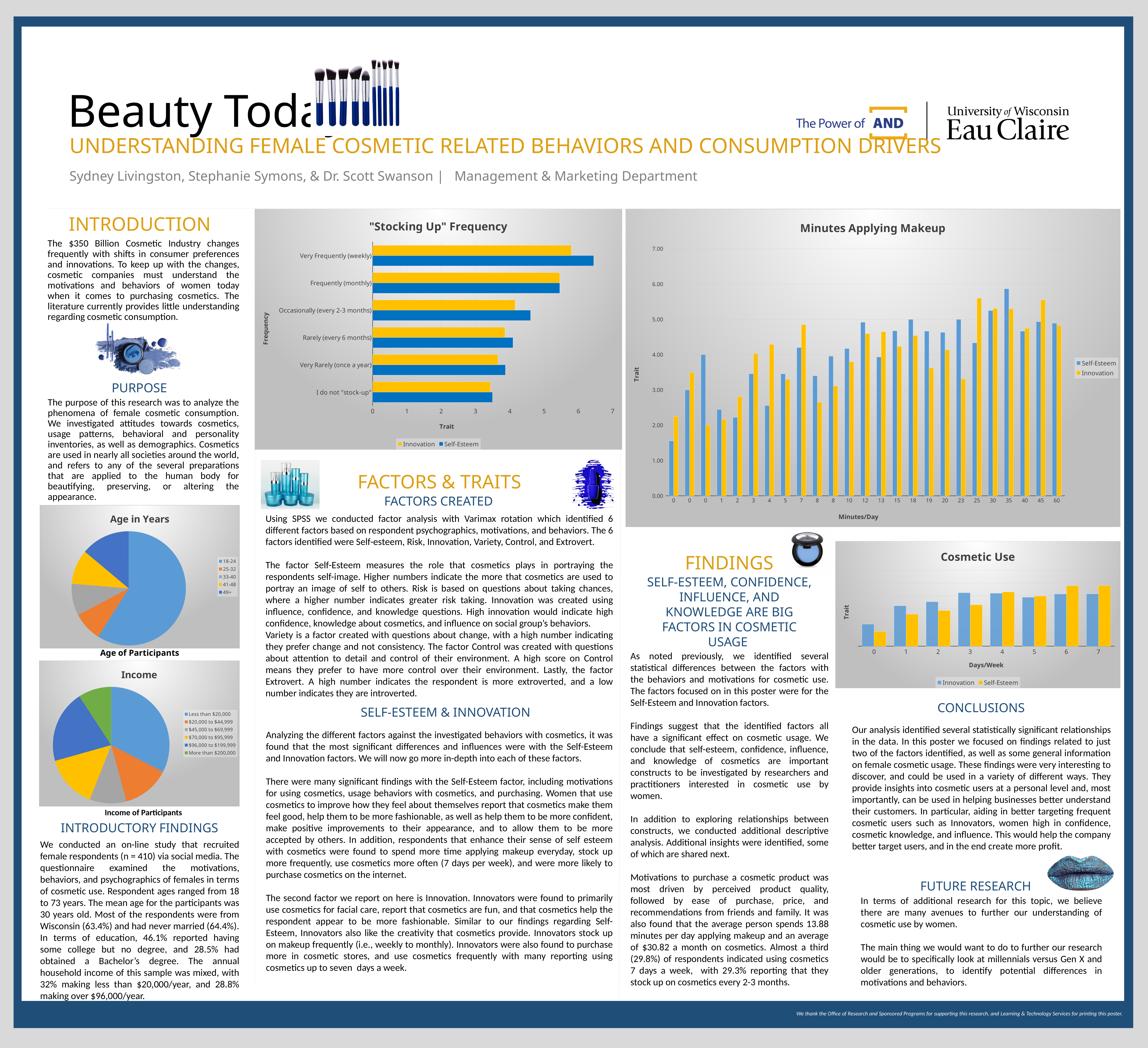
How many categories does the legend of the Income pie chart list? 6 In the "Stocking Up" Frequency chart, is the Self-Esteem value for Very Frequently (weekly) greater or less than 6? greater How many series does the legend of the "Stocking Up" Frequency chart list? 2 In the "Stocking Up" Frequency chart, which category has the highest Self-Esteem value? Very Frequently (weekly) How many categories are shown on the "Stocking Up" Frequency chart? 6 In the "Stocking Up" Frequency chart, which category has the lowest Self-Esteem value? I do not "stock-up" What type of chart is the "Stocking Up" Frequency chart? bar chart In the Cosmetic Use chart, which Days/Week category has the lowest Innovation value? 0 What type of chart is the Age in Years chart? pie chart In the Age in Years pie chart, which age group has the largest slice? 18-24 In the Minutes Applying Makeup chart, which Minutes/Day category has the highest Self-Esteem value? 35 In the Minutes Applying Makeup chart, is the Self-Esteem value for the first 0 category greater or less than 2.00? less